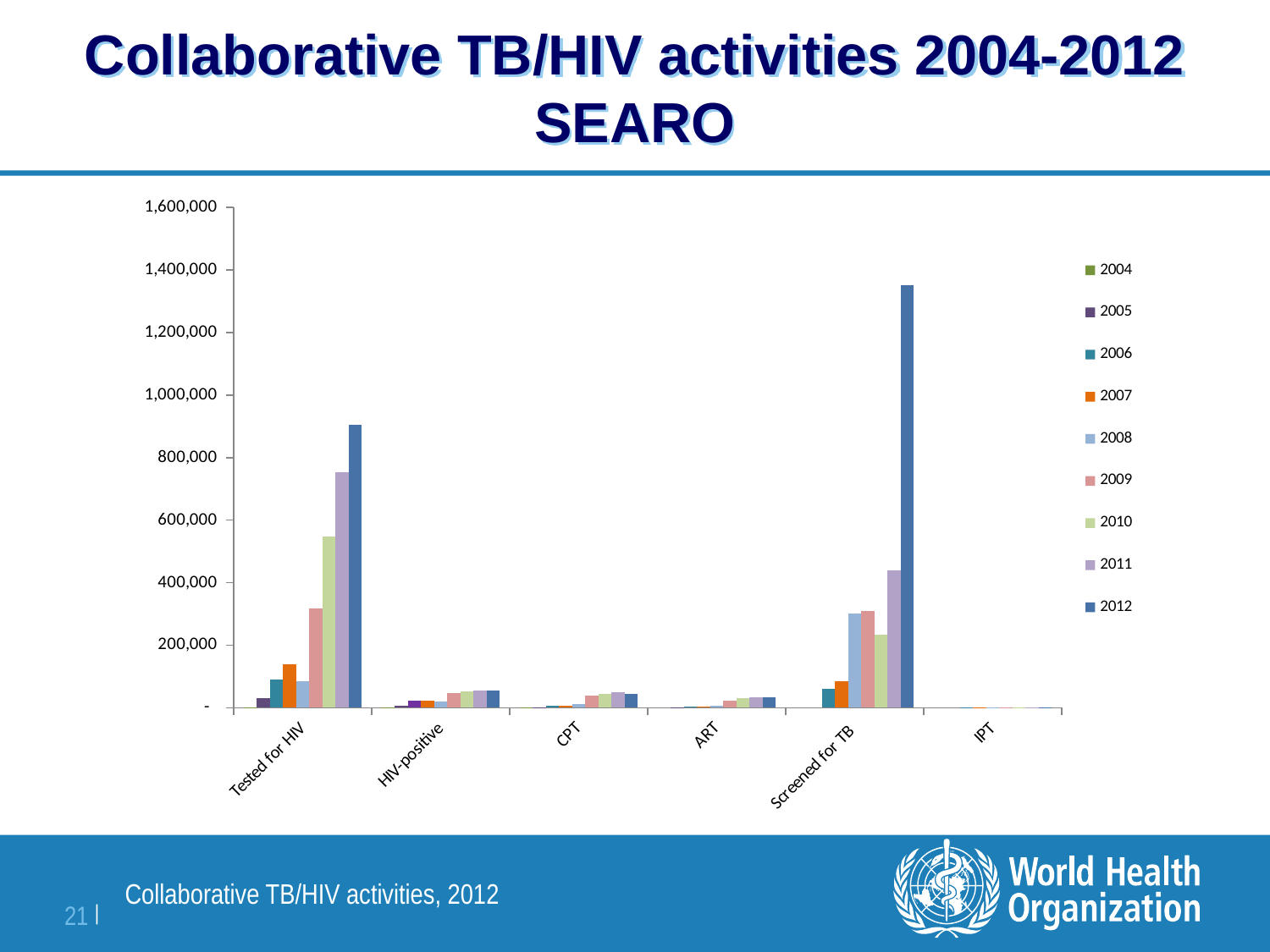
Which category has the tallest bar in the chart? Screened for TB Is the 2012 value for Screened for TB greater or less than 1,200,000? greater Is the 2011 value for Tested for HIV greater or less than 800,000? less Do the values for Tested for HIV rise or fall from 2004 to 2012? rise Is the 2012 value for Tested for HIV greater or less than 800,000? greater How many categories are shown on the x axis of the chart? 6 Which category has the smallest bars overall in the chart? IPT What is the title of the slide containing the chart? Collaborative TB/HIV activities 2004-2012 SEARO Which is larger in 2012: the value for Tested for HIV or the value for Screened for TB? Screened for TB How many series does the legend list? 9 What kind of chart is shown on the slide? Bar chart